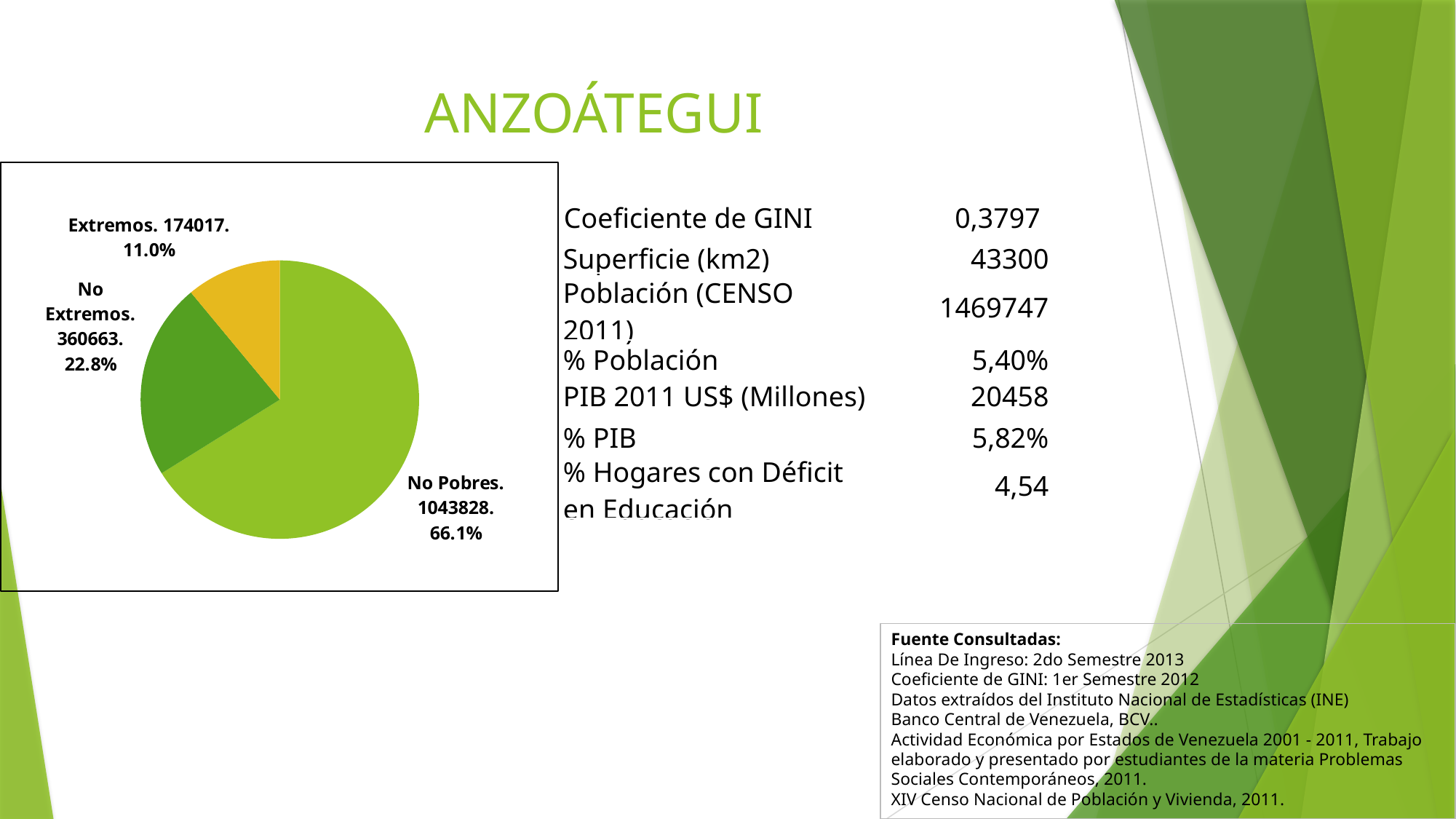
What share of the pie does the No Extremos slice represent? 22.8% What share of the pie does the No Pobres slice represent? 66.1% What is the value shown for the No Pobres slice? 1043828 Which slice of the pie chart is the smallest? Extremos What type of chart is shown on the slide? Pie chart Which slice of the pie chart is the largest? No Pobres What is the value shown for the Extremos slice? 174017 How many slices does the pie chart have? 3 What share of the pie does the Extremos slice represent? 11.0% What is the difference between the No Pobres value and the No Extremos value? 683165 Which slice is larger, No Extremos or Extremos? No Extremos What is the value shown for the No Extremos slice? 360663